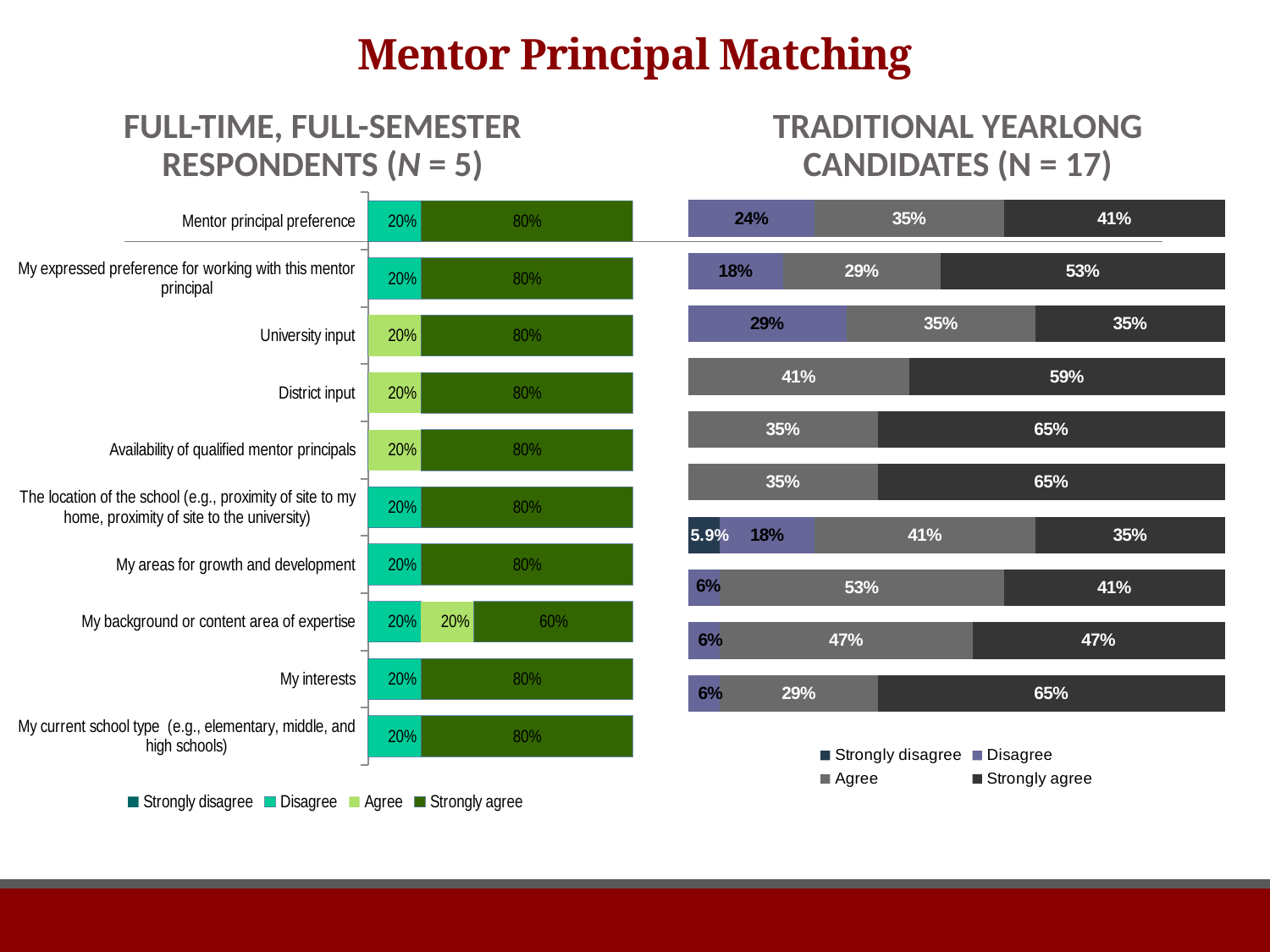
How many series does the legend of the Full-Time, Full-Semester Respondents chart list? 4 In the Traditional Yearlong Candidates chart, what is the Strongly agree value in the second bar from the top? 53% In the Traditional Yearlong Candidates chart, what is the Strongly disagree value shown in the seventh bar from the top? 5.9% In the Traditional Yearlong Candidates chart, what is the Strongly agree value in the bottom bar? 65% In the Traditional Yearlong Candidates chart, in the fourth bar from the top, which is larger: Agree or Strongly agree? Strongly agree In the Traditional Yearlong Candidates chart, what is the Strongly agree value in the top bar? 41% In the Full-Time, Full-Semester Respondents chart, what is the Strongly agree value for "District input"? 80% How many categories are listed in the Full-Time, Full-Semester Respondents chart? 10 In the Full-Time, Full-Semester Respondents chart, how much larger is the Strongly agree value for "My interests" than for "My background or content area of expertise"? 20 percentage points What kind of chart is the Traditional Yearlong Candidates chart? Stacked bar chart In the Full-Time, Full-Semester Respondents chart, what is the Strongly agree value for "My background or content area of expertise"? 60% In the Full-Time, Full-Semester Respondents chart, what is the Agree value for "My background or content area of expertise"? 20%